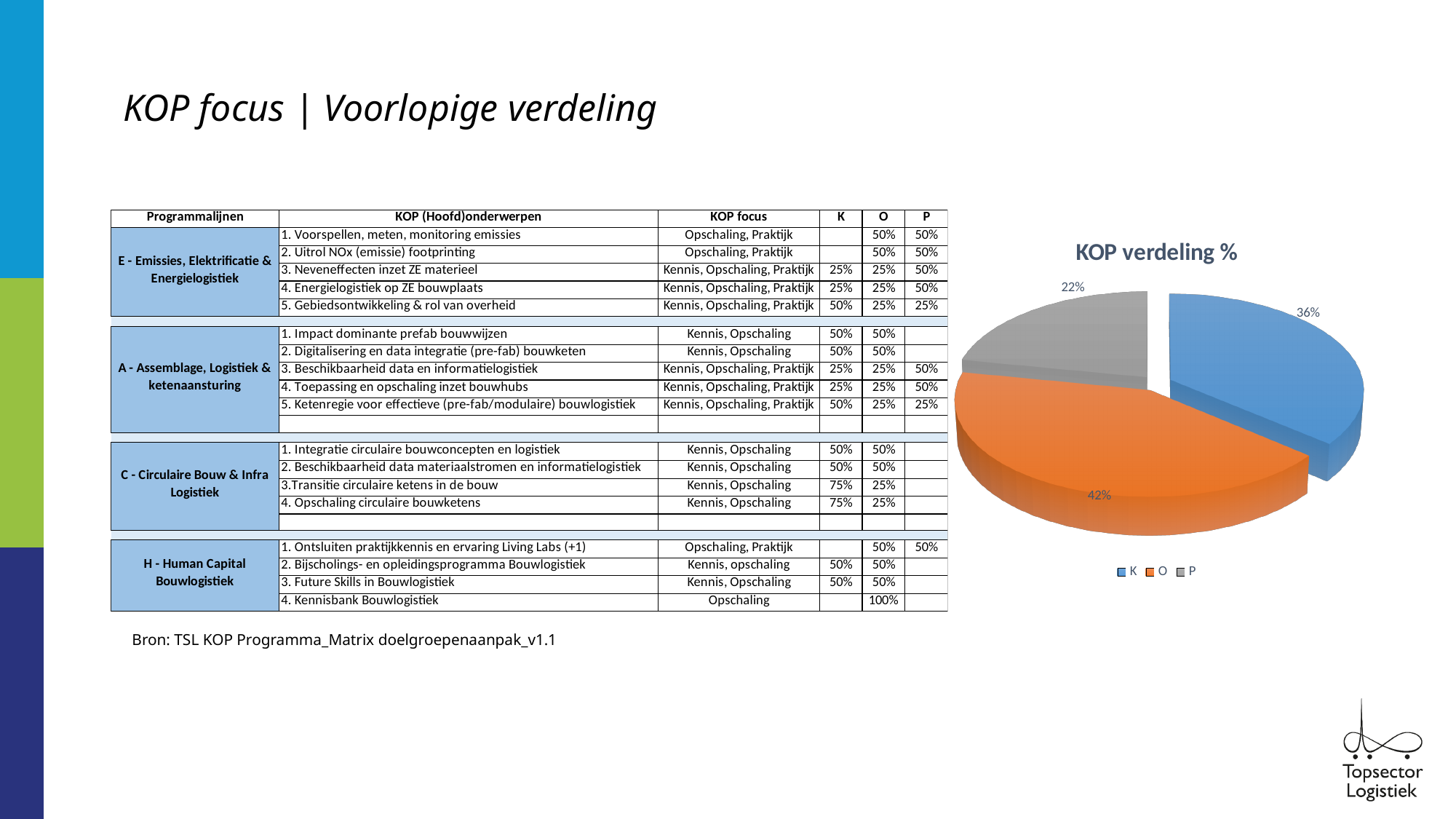
Which category has the smallest slice of the pie? P What is the difference in percentage points between the O slice and the K slice? 6% Which is larger, the slice for K or the slice for P? K What type of chart is shown on the slide? pie chart Which category has the largest slice of the pie? O How many entries does the legend list? 3 What share of the pie does O have? 42% How many slices does the pie chart have? 3 What is the difference in percentage points between the K slice and the P slice? 14% What is the title of the chart? KOP verdeling % What share of the pie does K have? 36% What share of the pie does P have? 22%